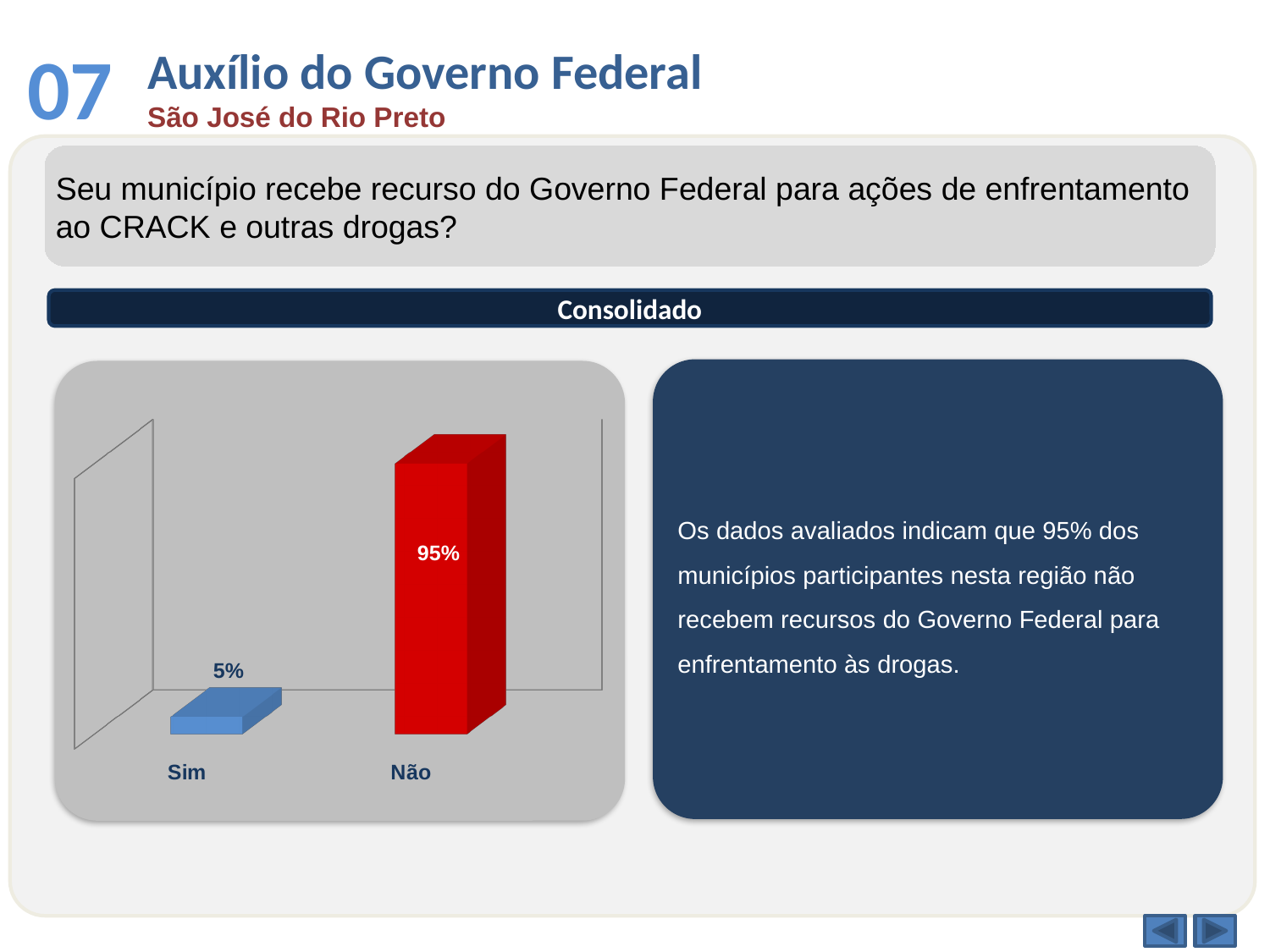
What is the total of the values for "Sim" and "Não"? 100% Which category has the lowest value? Sim Which is larger, the value for "Sim" or the value for "Não"? Não How many categories are shown in the chart? 2 What kind of chart is shown on the slide? Bar chart What is the value for "Sim"? 5% What colour is the bar for "Não"? Red What is the value for "Não"? 95% Which category has the highest value? Não What colour is the bar for "Sim"? Blue What is the difference between the values for "Não" and "Sim"? 90%